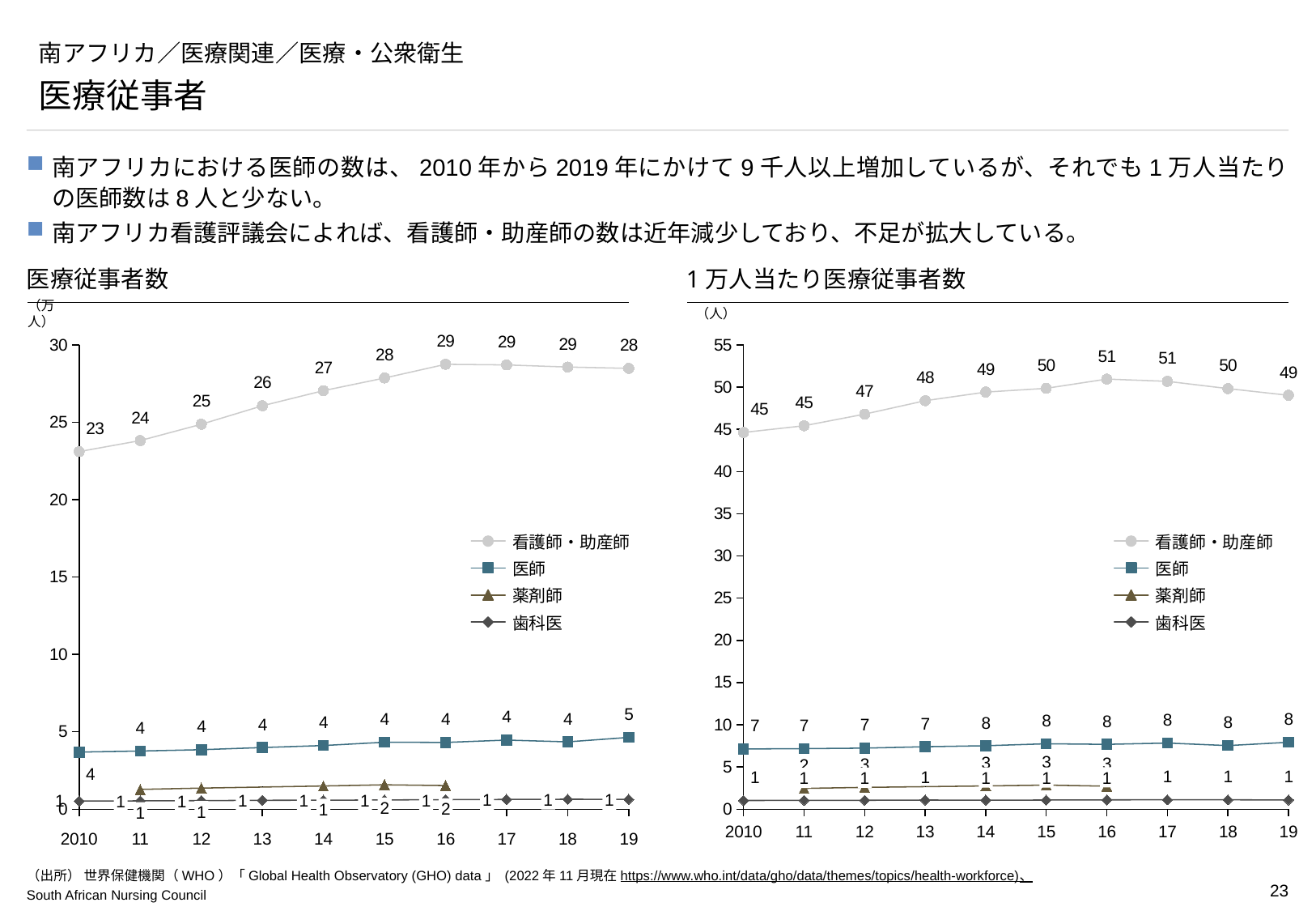
In the 1万人当たり医療従事者数 chart, which is larger, the 看護師・助産師 value for 2012 or for 2015? 2015 What kind of chart is the 1万人当たり医療従事者数 chart? line chart In the 1万人当たり医療従事者数 chart, is the 看護師・助産師 value for 2010 greater or less than 40? greater In the 1万人当たり医療従事者数 chart, what is the value for 医師 in 2019? 8 In the 医療従事者数 chart, what is the difference between the 看護師・助産師 values for 2019 and 2010? 5 In the 医療従事者数 chart, what is the value for 看護師・助産師 in 2010? 23 In the 医療従事者数 chart, what is the value for 医師 in 2019? 5 In the 医療従事者数 chart, which year has the lowest value for 看護師・助産師? 2010 In the 1万人当たり医療従事者数 chart, what is the value for 看護師・助産師 in 2016? 51 In the 医療従事者数 chart, what is the value for 看護師・助産師 in 2016? 29 In the 1万人当たり医療従事者数 chart, what is the value for 医師 in 2010? 7 How many series does the legend of the 医療従事者数 chart list? 4